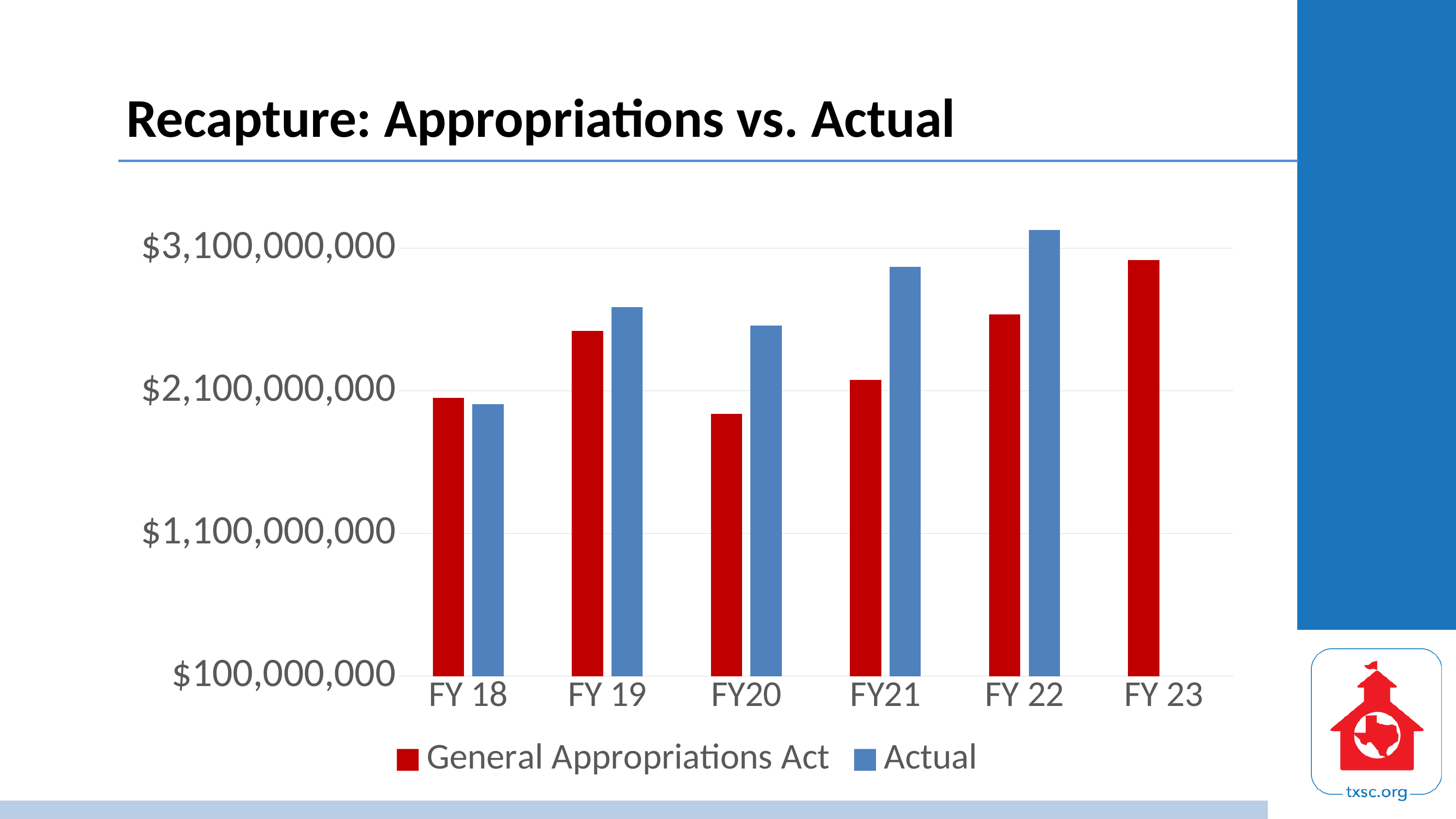
How many fiscal years are shown on the x axis? 6 Is the Actual value for FY 22 greater or less than $3,100,000,000? greater Do the Actual values rise or fall from FY 18 to FY 22? rise Which fiscal year has the highest General Appropriations Act value? FY 23 In FY 22, which is larger: the General Appropriations Act value or the Actual value? Actual What is the title of the chart? Recapture: Appropriations vs. Actual How many series does the legend list? 2 Which fiscal year has the lowest General Appropriations Act value? FY20 Is the General Appropriations Act value for FY20 greater or less than $2,100,000,000? less Which fiscal year has the highest Actual value? FY 22 Which fiscal year has the lowest Actual value? FY 18 What kind of chart is shown on the slide? bar chart